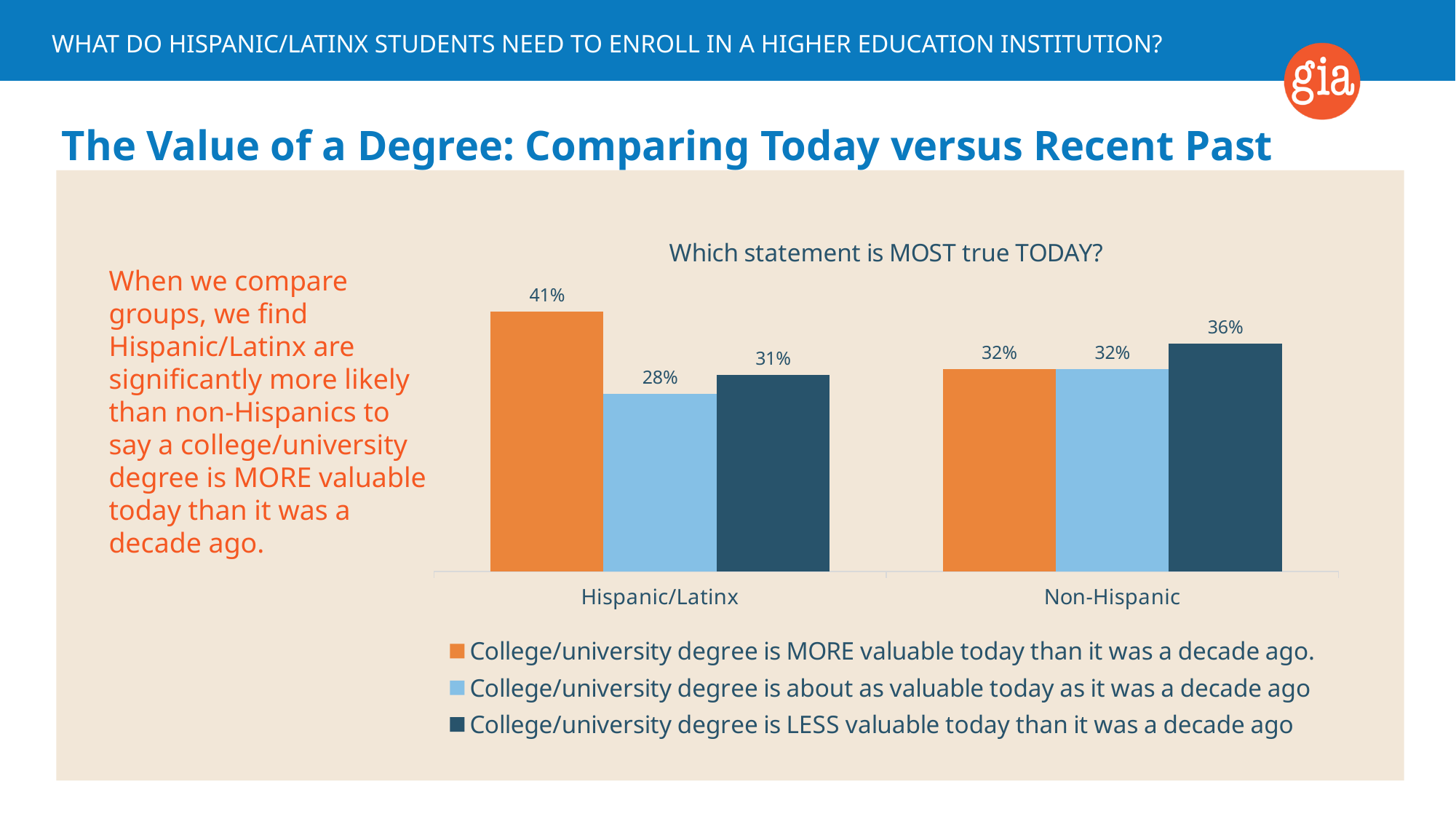
Which group has a higher percentage saying a degree is LESS valuable today than a decade ago, Hispanic/Latinx or Non-Hispanic? Non-Hispanic What percentage of Non-Hispanic respondents say a college/university degree is LESS valuable today than it was a decade ago? 36% How many series does the chart legend list? 3 What percentage of Non-Hispanic respondents say a college/university degree is MORE valuable today than it was a decade ago? 32% Which statement has the lowest percentage among Hispanic/Latinx respondents? College/university degree is about as valuable today as it was a decade ago What type of chart is shown on the slide? Bar chart What percentage of Hispanic/Latinx respondents say a college/university degree is MORE valuable today than it was a decade ago? 41% Which statement has the highest percentage among Non-Hispanic respondents? College/university degree is LESS valuable today than it was a decade ago What is the difference between the Hispanic/Latinx and Non-Hispanic percentages for 'degree is MORE valuable today'? 9 percentage points Which statement has the highest percentage among Hispanic/Latinx respondents? College/university degree is MORE valuable today than it was a decade ago. What percentage of Hispanic/Latinx respondents say a college/university degree is about as valuable today as it was a decade ago? 28% How many groups are shown on the x axis of the chart? 2